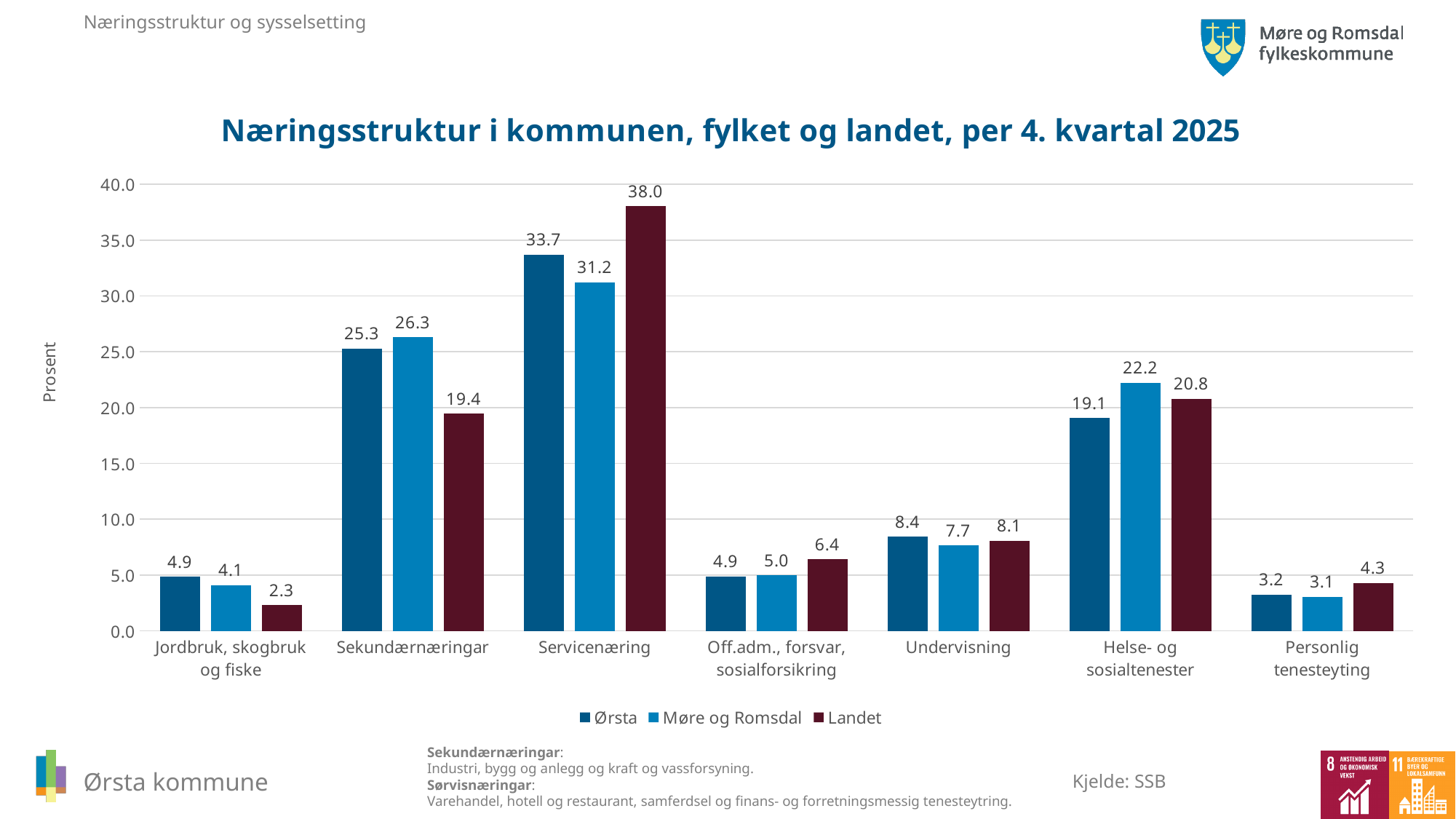
What is the value for Møre og Romsdal in Helse- og sosialtenester? 22.2 How many series does the legend list? 3 What kind of chart is shown on the slide? Bar chart What is the value for Landet in Sekundærnæringar? 19.4 What is the title of the chart? Næringsstruktur i kommunen, fylket og landet, per 4. kvartal 2025 Which category has the highest value for Landet? Servicenæring Is the value for Møre og Romsdal in Sekundærnæringar greater or less than 25.0? greater Which category has the lowest value for Ørsta? Personlig tenesteyting What is the difference between Landet and Ørsta in Servicenæring? 4.3 How many categories are shown on the x axis? 7 What is the value for Ørsta in Servicenæring? 33.7 Which is larger in Undervisning: Ørsta or Møre og Romsdal? Ørsta